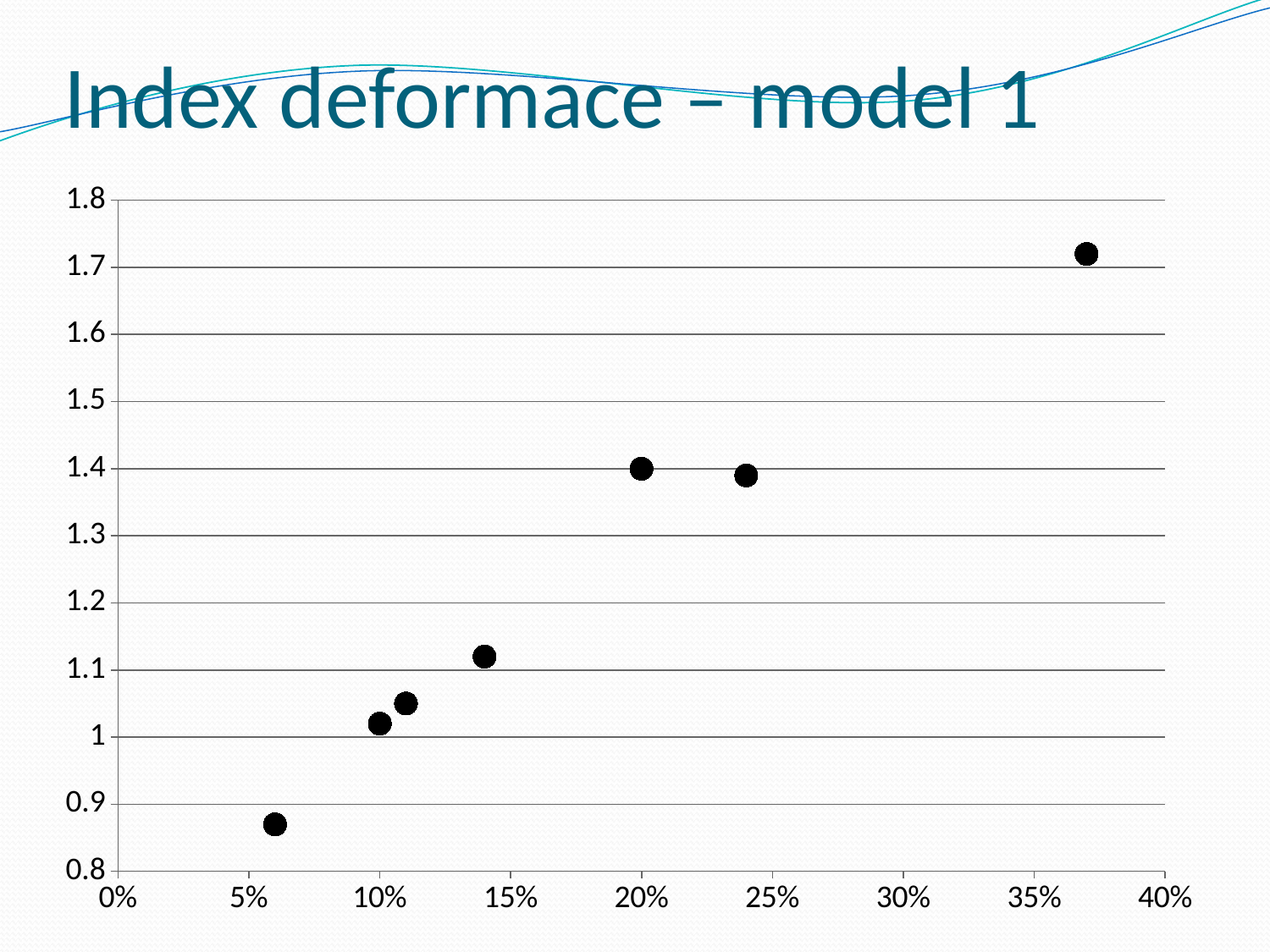
Is the value of the point at 37% on the x axis greater or less than 1.7? greater Is the value of the point at 14% on the x axis greater or less than 1.1? greater Which point has the larger value: the one at 14% or the one at 20%? 20% Is the value of the point at 6% on the x axis greater or less than 0.9? less Do the plotted values generally rise or fall as the x-axis percentage increases? rise What kind of chart is shown on the slide? scatter chart How many data points are plotted on the chart? 7 What is the title of the chart slide? Index deformace – model 1 At which x-axis value is the highest point plotted? 37% At which x-axis value is the lowest point plotted? 6%